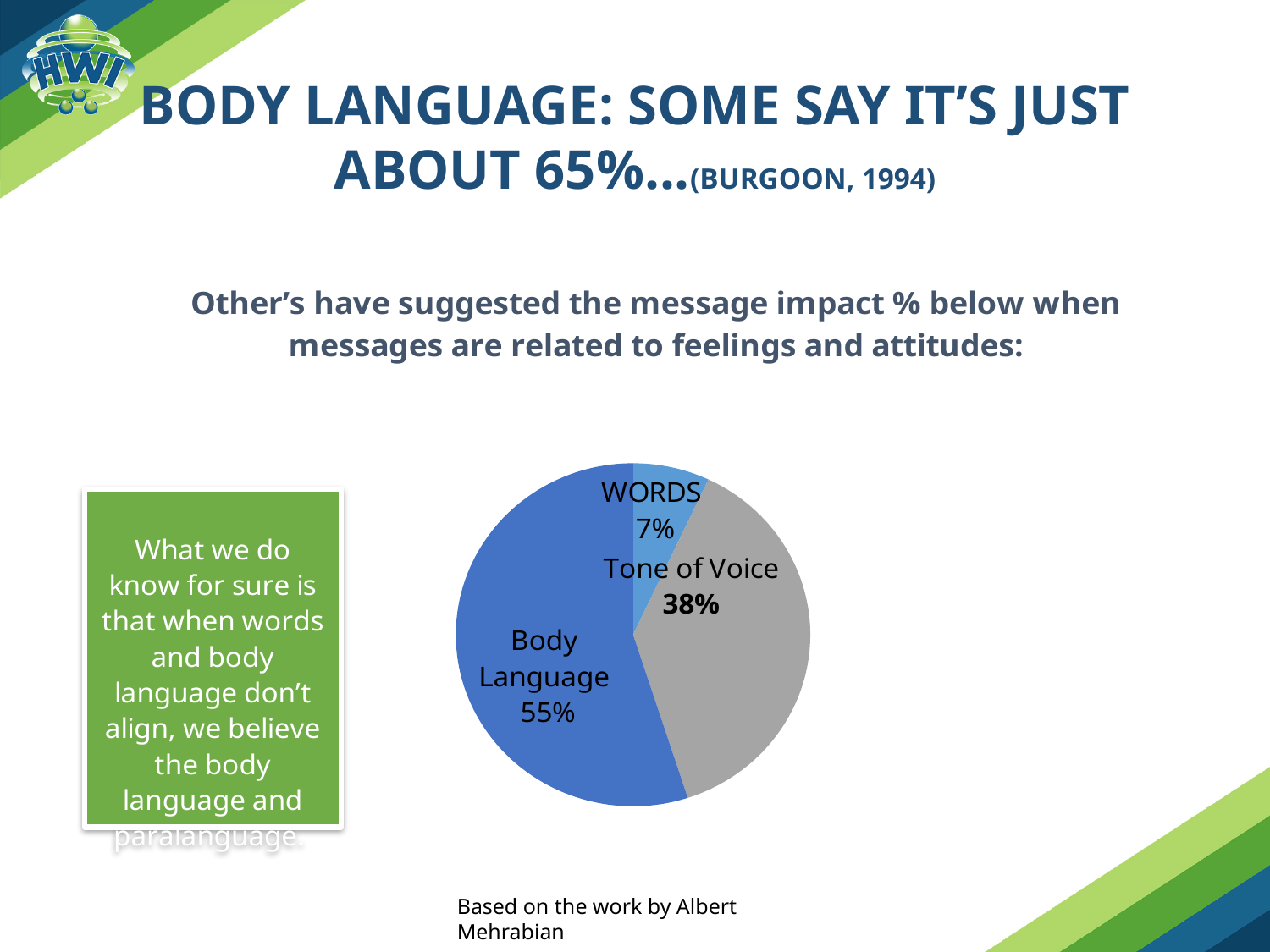
What colour is the Tone of Voice slice? grey What percentage is shown for WORDS? 7% Which slice of the pie chart is the smallest? WORDS Which slice of the pie chart is the largest? Body Language What kind of chart is shown on the slide? pie chart What percentage is shown for Body Language? 55% What colour is the Body Language slice? blue What percentage is shown for Tone of Voice? 38% How many slices does the pie chart have? 3 What is the difference between the Tone of Voice and WORDS percentages? 31% What is the difference between the Body Language and Tone of Voice percentages? 17% Which is larger, Tone of Voice or WORDS? Tone of Voice